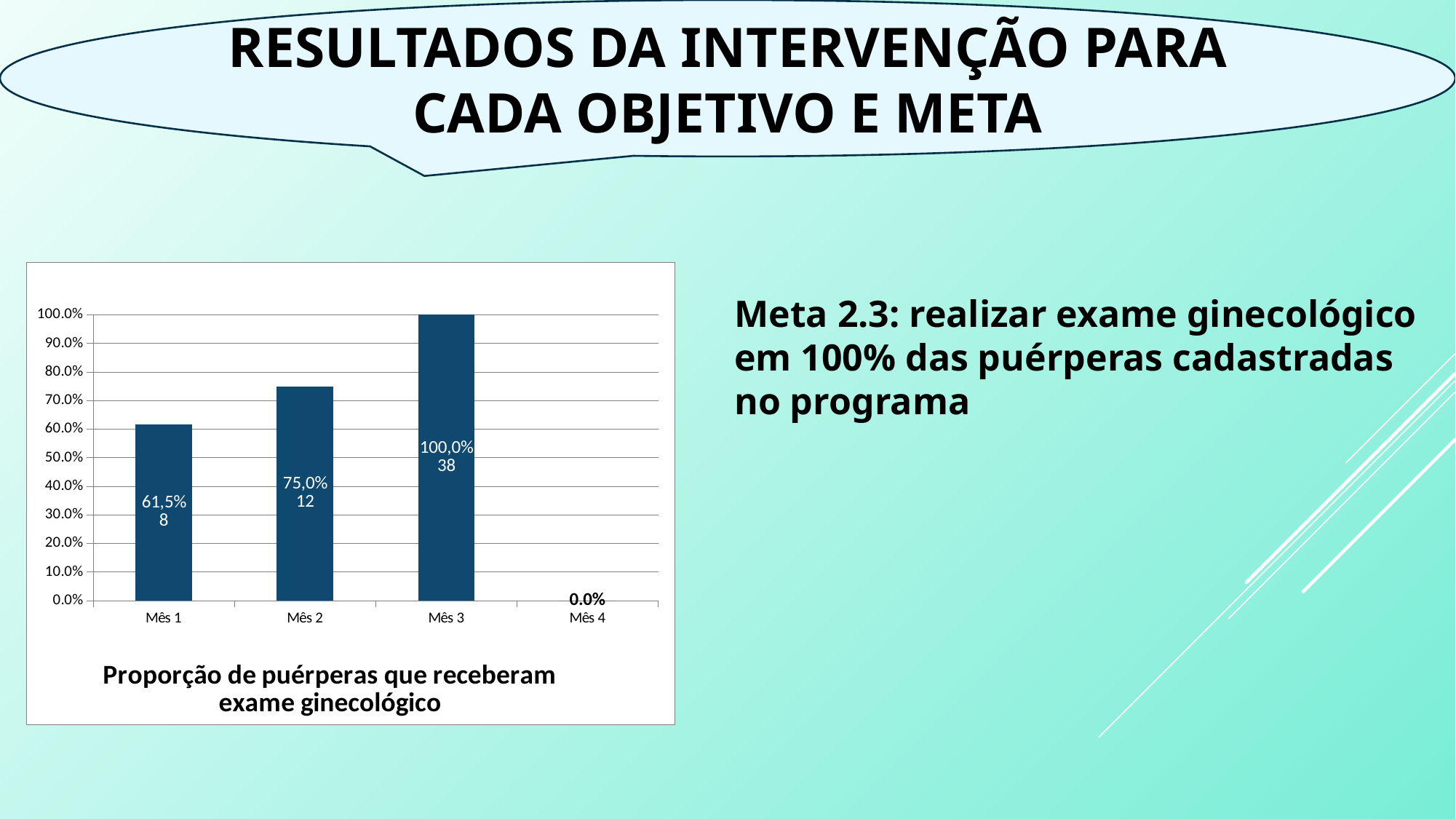
Which month has the highest percentage? Mês 3 What is the difference in percentage between Mês 3 and Mês 2? 25,0% What percentage is shown for Mês 3? 100,0% What count is printed on the bar for Mês 1? 8 Which month has the lowest percentage? Mês 4 What is the title of the chart? Proporção de puérperas que receberam exame ginecológico What count is printed on the bar for Mês 3? 38 What percentage is shown for Mês 2? 75,0% Which has a higher percentage, Mês 1 or Mês 2? Mês 2 What percentage is shown for Mês 1? 61,5% How many months are shown on the x axis? 4 What kind of chart is shown on the slide? Bar chart